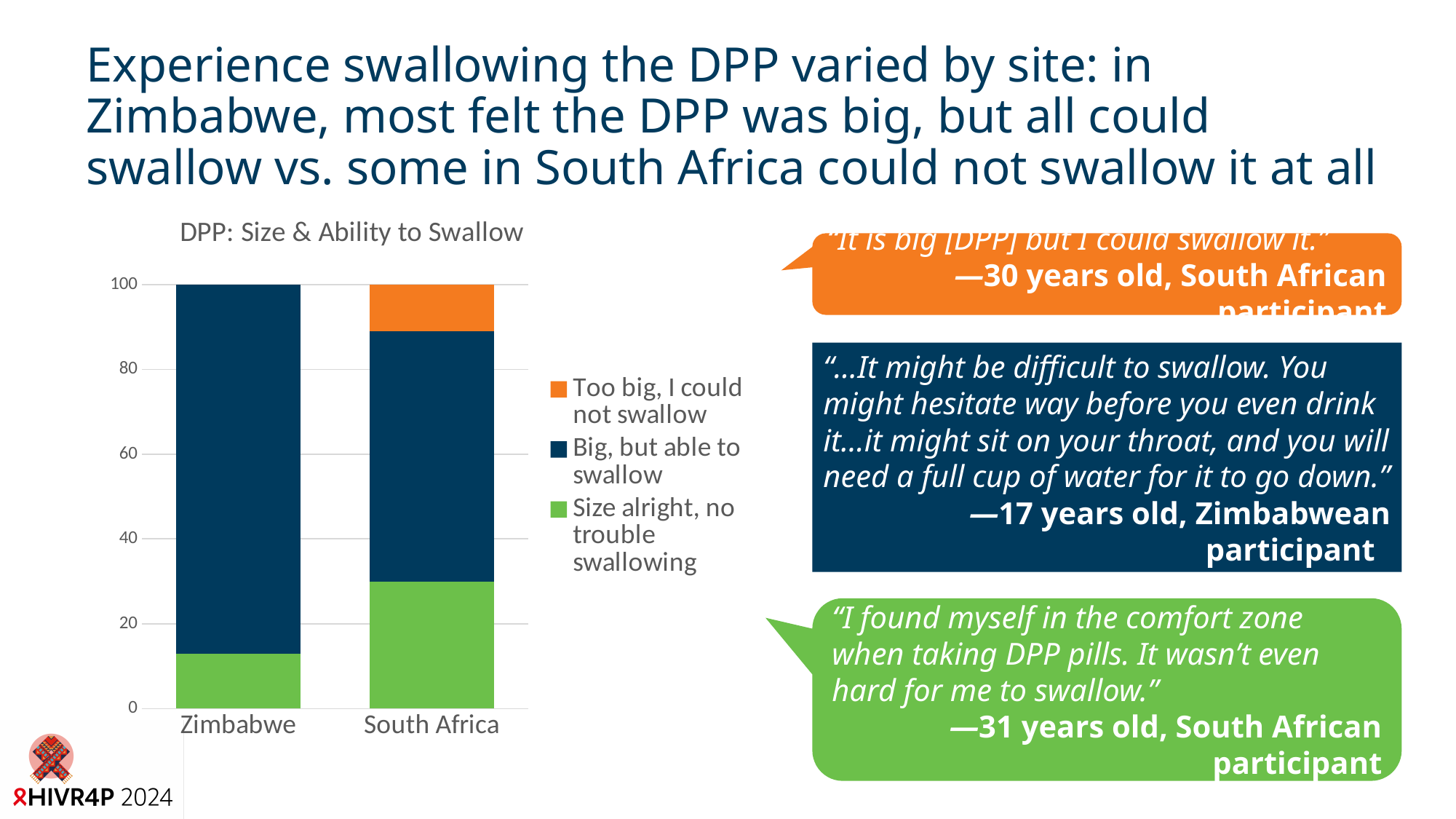
What is the total height of the stacked bar for Zimbabwe? 100 How many series does the chart's legend list? 3 Which site has the larger 'Big, but able to swallow' segment, Zimbabwe or South Africa? Zimbabwe What kind of chart is shown on the slide? Stacked bar chart What is the title of the chart? DPP: Size & Ability to Swallow Is the value for 'Size alright, no trouble swallowing' in South Africa greater or less than 20? greater Is the value for 'Too big, I could not swallow' in South Africa greater or less than 20? less Is the value for 'Size alright, no trouble swallowing' in Zimbabwe greater or less than 20? less How many categories are shown on the x axis of the chart? 2 Which site has the larger 'Size alright, no trouble swallowing' segment, Zimbabwe or South Africa? South Africa Which legend entry is shown in orange? Too big, I could not swallow